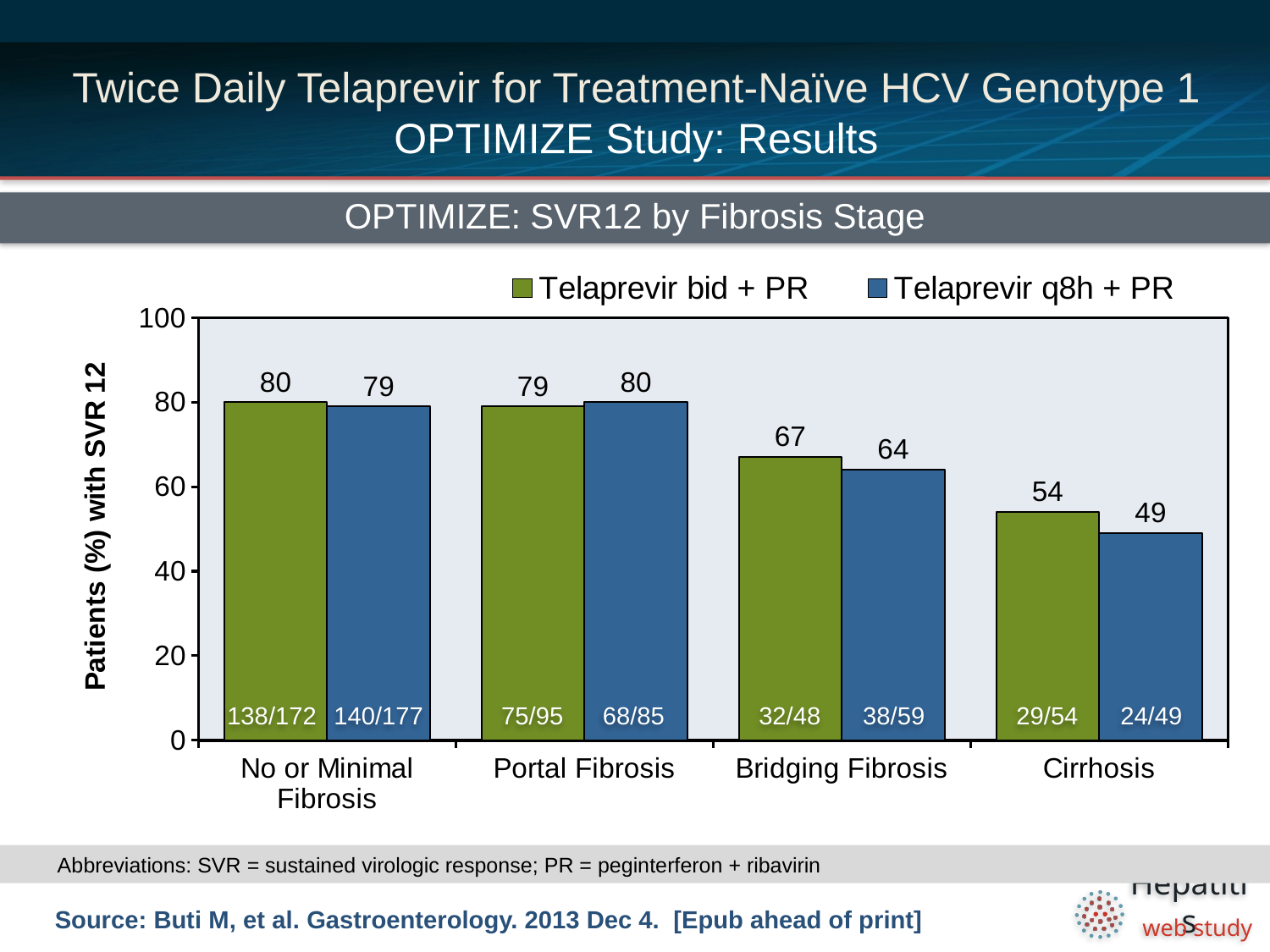
What is the title of the chart? OPTIMIZE: SVR12 by Fibrosis Stage What is the SVR12 rate for Telaprevir q8h + PR in patients with Bridging Fibrosis? 64 What is the SVR12 rate for Telaprevir q8h + PR in patients with No or Minimal Fibrosis? 79 What kind of chart is shown on the slide? Bar chart In patients with Bridging Fibrosis, which regimen has the higher SVR12 rate, Telaprevir bid + PR or Telaprevir q8h + PR? Telaprevir bid + PR Do the SVR12 rates for Telaprevir bid + PR rise or fall as fibrosis stage progresses from No or Minimal Fibrosis to Cirrhosis? Fall How many series does the legend list? 2 How many fibrosis stage categories are shown on the x axis? 4 Which fibrosis stage has the lowest SVR12 rate for Telaprevir q8h + PR? Cirrhosis What is the SVR12 rate for Telaprevir bid + PR in patients with Cirrhosis? 54 What is the difference between the Telaprevir bid + PR and Telaprevir q8h + PR SVR12 rates in patients with Cirrhosis? 5 Which fibrosis stage has the highest SVR12 rate for Telaprevir bid + PR? No or Minimal Fibrosis